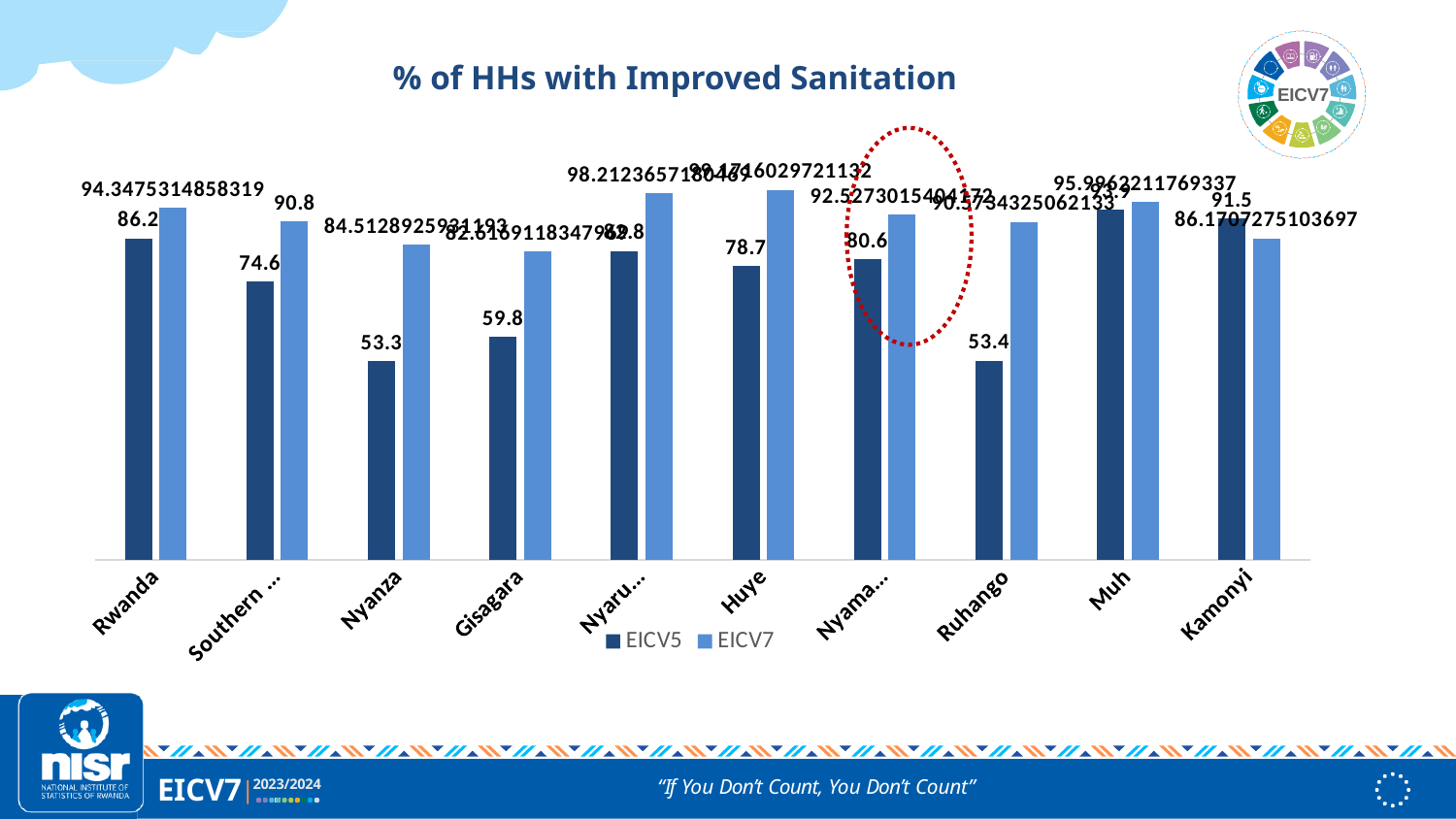
What kind of chart is shown on the slide? bar chart What is the EICV5 value for Nyanza? 53.3 What is the EICV7 value for Southern? 90.8 How many categories are shown on the x axis? 10 For Kamonyi, which series has the larger value, EICV5 or EICV7? EICV5 How many series does the legend list? 2 What is the EICV5 value for Rwanda? 86.2 What is the title of the chart? % of HHs with Improved Sanitation Which has the larger EICV5 value, Gisagara or Huye? Huye What is the EICV7 value for Kamonyi? 86.1707275103697 What is the difference between the EICV5 values for Rwanda and Southern? 11.6 What is the EICV5 value for Ruhango? 53.4